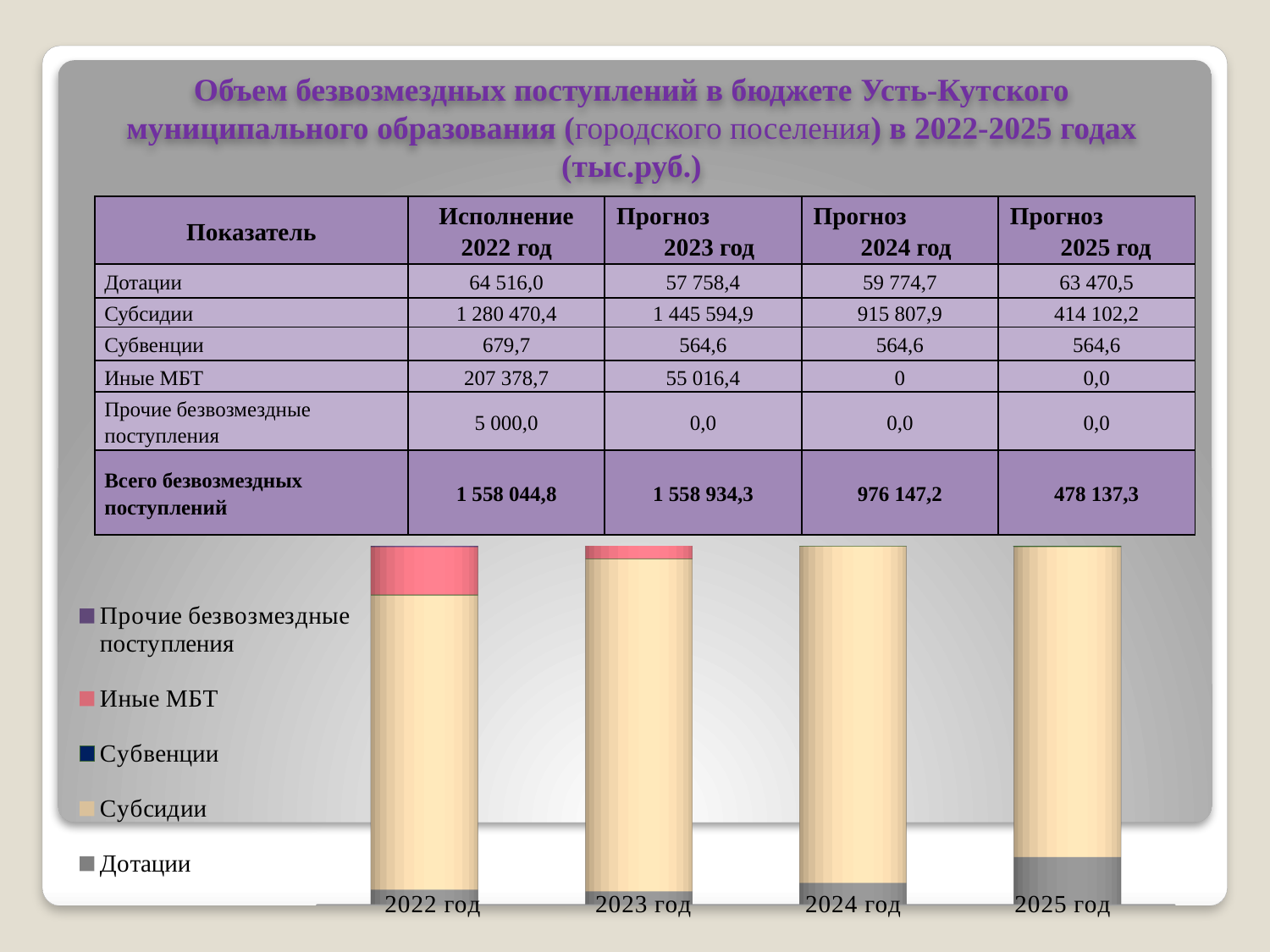
According to the table, what is the Субсидии value for Прогноз 2023 год? 1 445 594,9 Which series takes up the largest share of every bar in the chart? Субсидии According to the table, what is the Дотации value for Исполнение 2022 год? 64 516,0 Does the Дотации segment grow or shrink from 2022 год to 2025 год? Grows Which series is shown in pink in the chart? Иные МБТ Which series is listed first (at the top) in the chart legend? Прочие безвозмездные поступления In the 2022 год bar, which segment is larger: Субсидии or Иные МБТ? Субсидии According to the table, what is the total of all безвозмездные поступления for Прогноз 2024 год? 976 147,2 How many years (bars) are shown on the x axis of the chart? 4 In which year is the Иные МБТ segment the largest? 2022 год What kind of chart is shown at the bottom of the slide? Stacked bar chart How many series does the chart legend list? 5